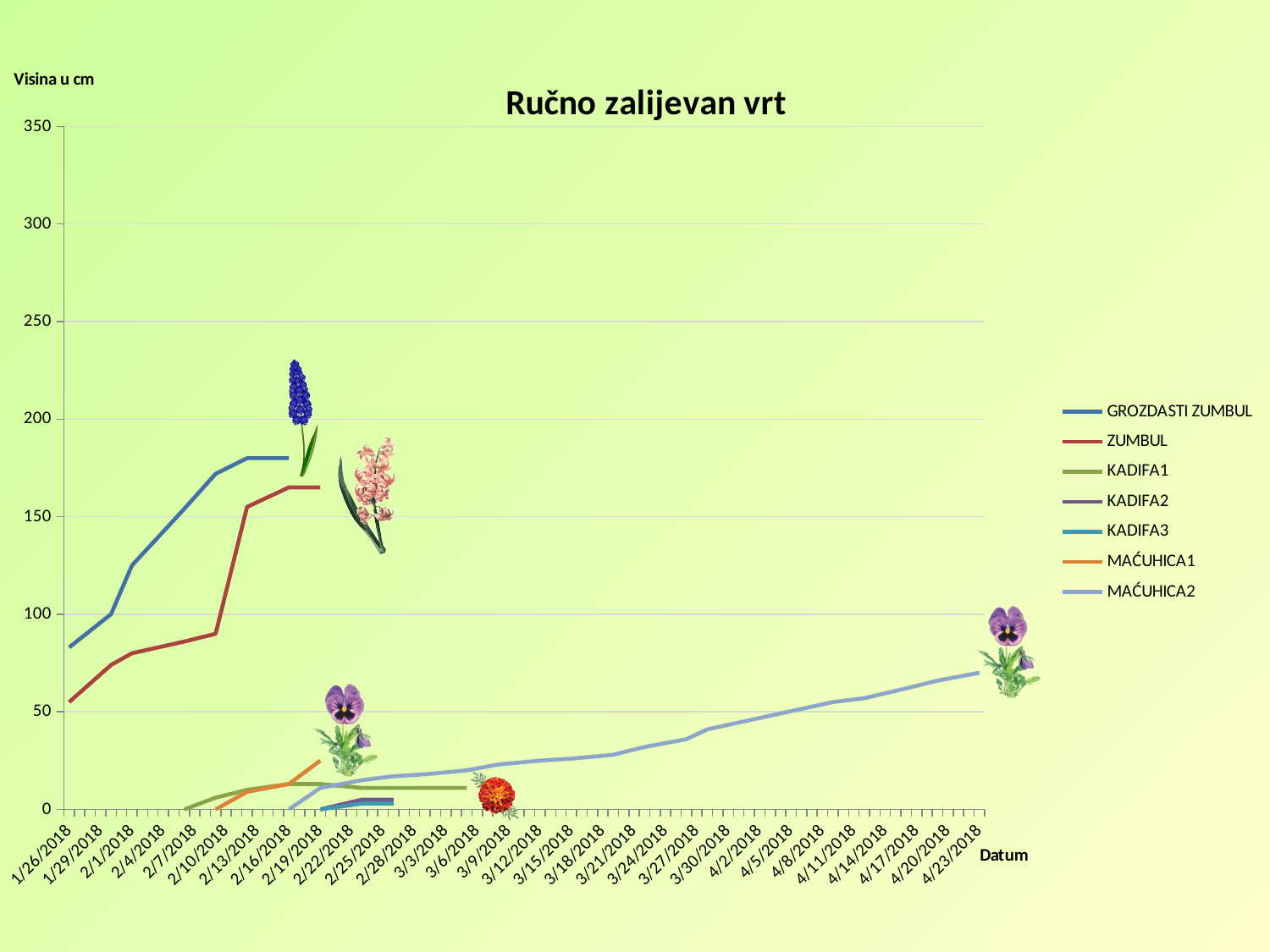
What kind of chart is shown on the slide? Line chart Do the values for MAĆUHICA2 rise or fall along the x axis? rise Is the value for MAĆUHICA2 on 4/23/2018 greater or less than 50? greater Is the value for GROZDASTI ZUMBUL on 2/16/2018 greater or less than 150? greater What is the title of the chart? Ručno zalijevan vrt Is the value for MAĆUHICA2 on 4/23/2018 greater or less than 100? less What is the label of the vertical axis? Visina u cm How many series does the legend list? 7 On 2/1/2018, which series has the larger value, GROZDASTI ZUMBUL or ZUMBUL? GROZDASTI ZUMBUL Which series reaches the highest value on the chart? GROZDASTI ZUMBUL Which series extends furthest to the right along the date axis? MAĆUHICA2